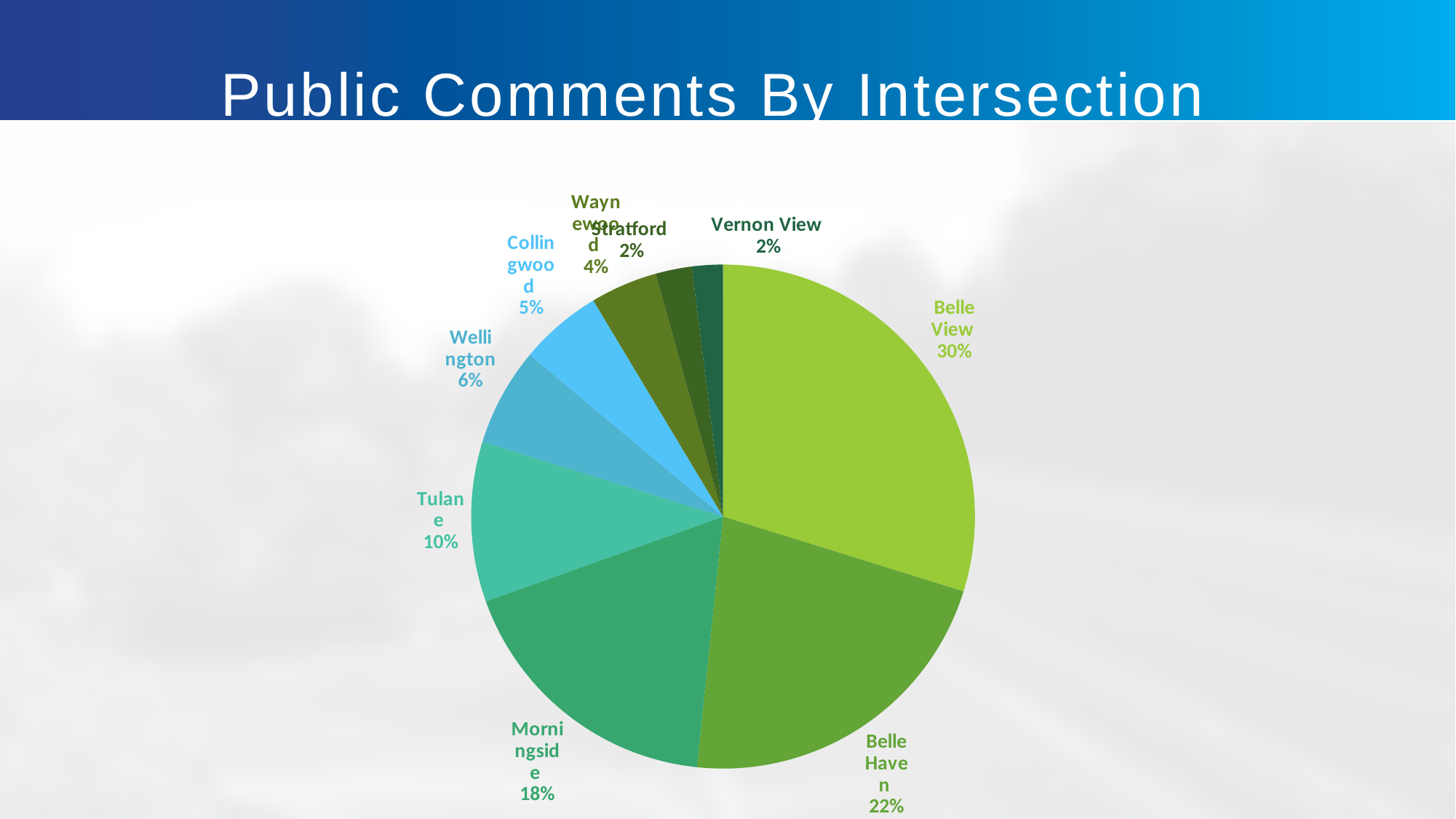
Which has a larger share of public comments, Morningside or Tulane? Morningside What kind of chart is shown on the slide? pie chart What share of public comments is for Morningside? 18% What is the difference in percentage points between Belle View and Belle Haven? 8 What share of public comments is for Wellington? 6% What share of public comments is for Belle View? 30% What is the combined share of Collingwood and Wellington? 11% Which intersection has the largest share of public comments? Belle View How many intersections are shown in the pie chart? 9 What share of public comments is for Waynewood? 4% What share of public comments is for Tulane? 10% What is the title of the chart on the slide? Public Comments By Intersection